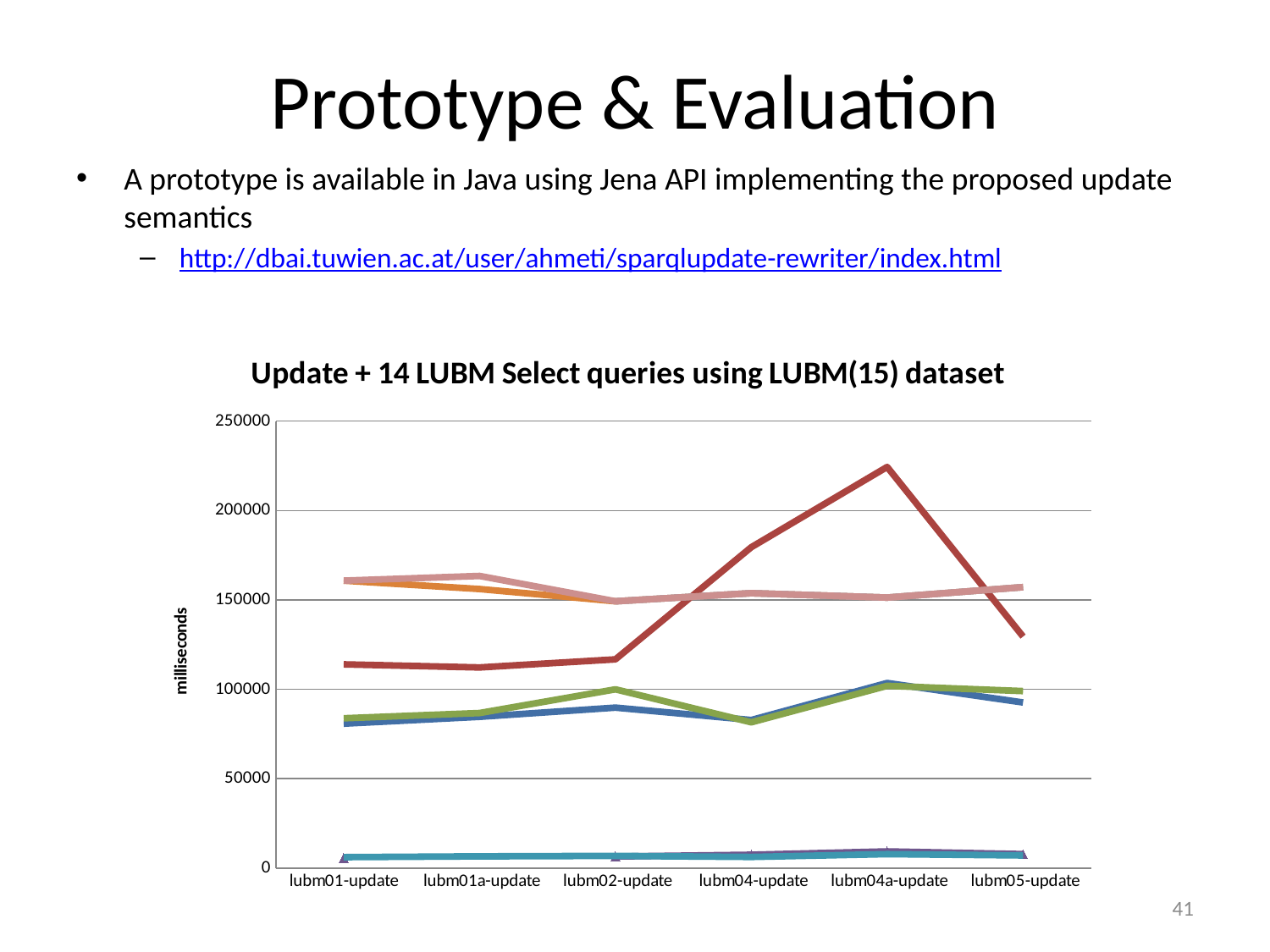
Is the value of the blue line at lubm01-update greater or less than 100000? less What is the label on the vertical axis of the chart? milliseconds Is the value of the dark red line at lubm01-update greater or less than 100000? greater At lubm04a-update, which line has the larger value, the dark red line or the pink line? the dark red line What is the title of the chart? Update + 14 LUBM Select queries using LUBM(15) dataset Does the dark red line rise or fall from lubm04a-update to lubm05-update? fall What kind of chart is shown on the slide? line chart Is the value of the pink line at lubm01-update greater or less than 150000? greater At which category does the dark red line reach its highest value? lubm04a-update How many categories are shown along the x axis of the chart? 6